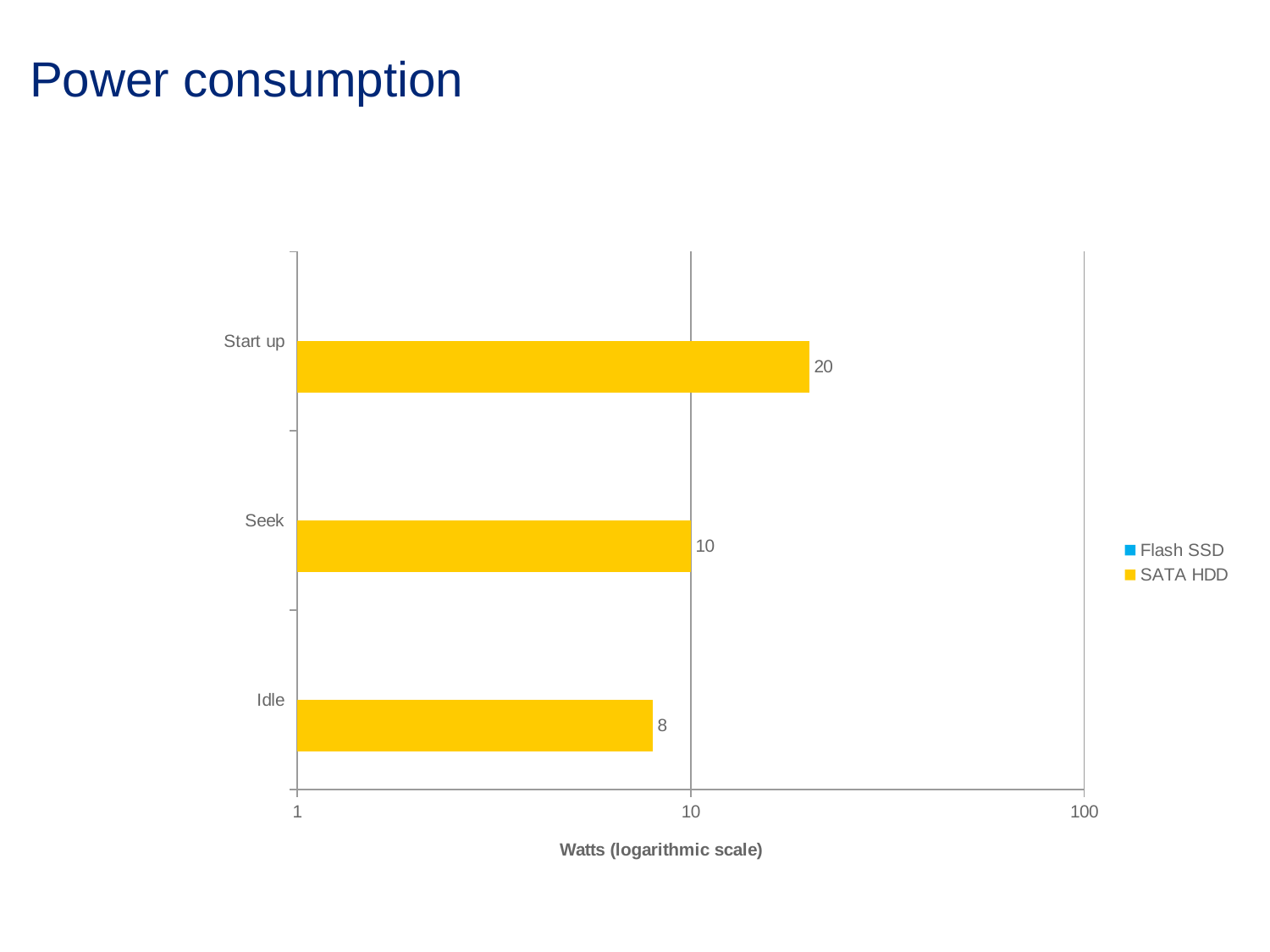
How many categories are shown on the chart? 3 What is the SATA HDD power consumption for Idle? 8 What is the difference between the SATA HDD values for Seek and Idle? 2 Is the SATA HDD value for Idle greater or less than 10? less Which category has the lowest SATA HDD power consumption? Idle Which is larger for SATA HDD: Start up or Seek? Start up What kind of chart is shown on the slide? bar chart What is the difference between the SATA HDD values for Start up and Idle? 12 What is the SATA HDD power consumption for Seek? 10 How many series does the legend list? 2 Which category has the highest SATA HDD power consumption? Start up What is the SATA HDD power consumption for Start up? 20